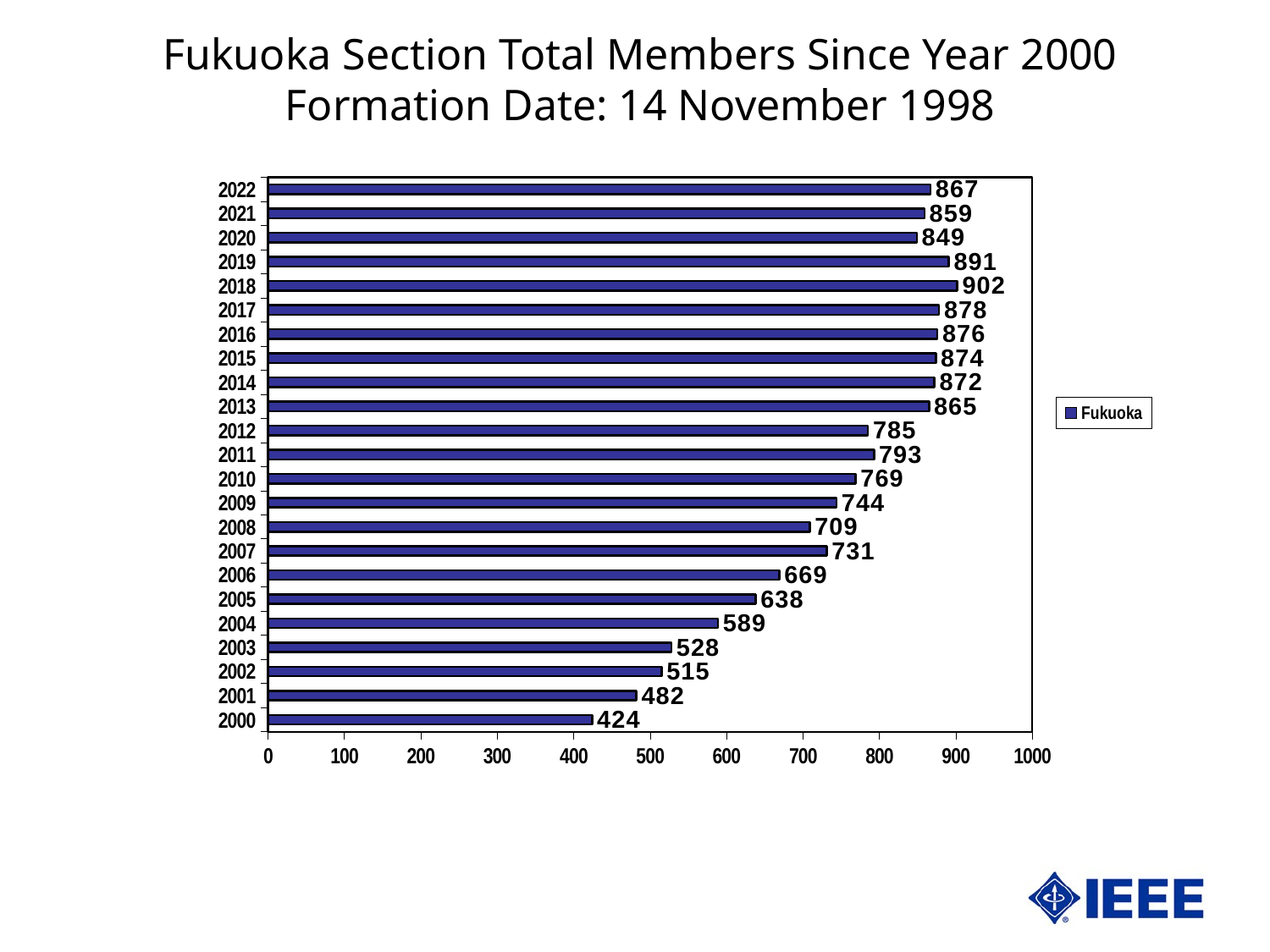
What is the value for 2018? 902 What series name is shown in the legend? Fukuoka How many series does the legend list? 1 Which is larger, the value for 2011 or the value for 2012? 2011 Which year has the highest value? 2018 What is the value for 2012? 785 Which year has the lowest value? 2000 What kind of chart is shown? bar chart How many years are shown on the chart? 23 What is the difference between the values for 2022 and 2000? 443 Is the value for 2005 greater or less than 600? greater What is the value for 2000? 424